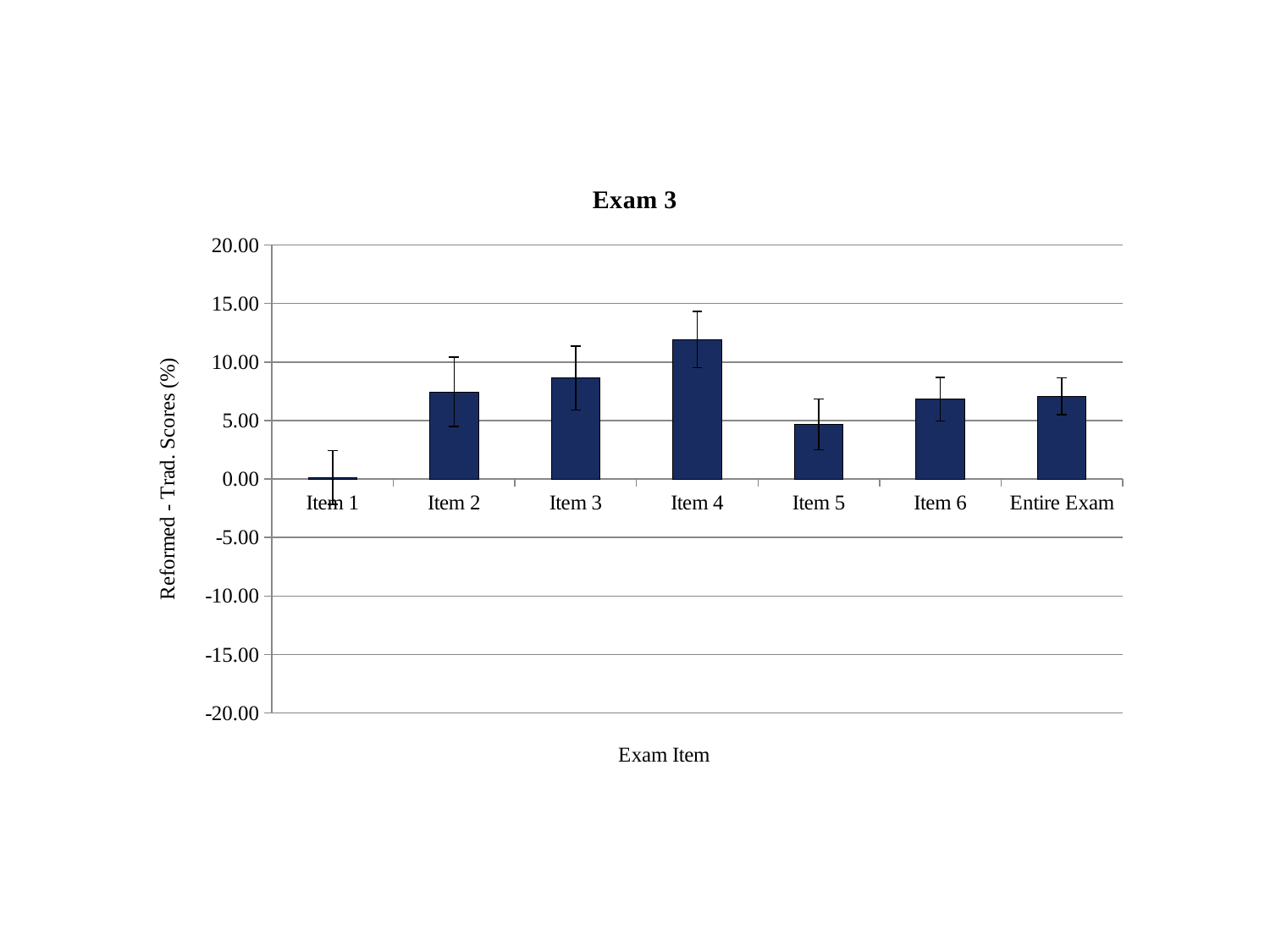
Is the value for Item 4 greater or less than 10.00? greater Which is larger, the value for Item 3 or the value for Item 5? Item 3 What kind of chart is shown on the slide? bar chart Which category has the highest value in the chart? Item 4 How many categories are shown on the x axis of the chart? 7 Which is larger, the value for Item 4 or the value for Item 5? Item 4 Which category has the lowest value in the chart? Item 1 Is the value for Item 3 greater or less than 10.00? less Is the value for Item 2 greater or less than 5.00? greater What is the label of the x axis of the chart? Exam Item What is the title of the chart? Exam 3